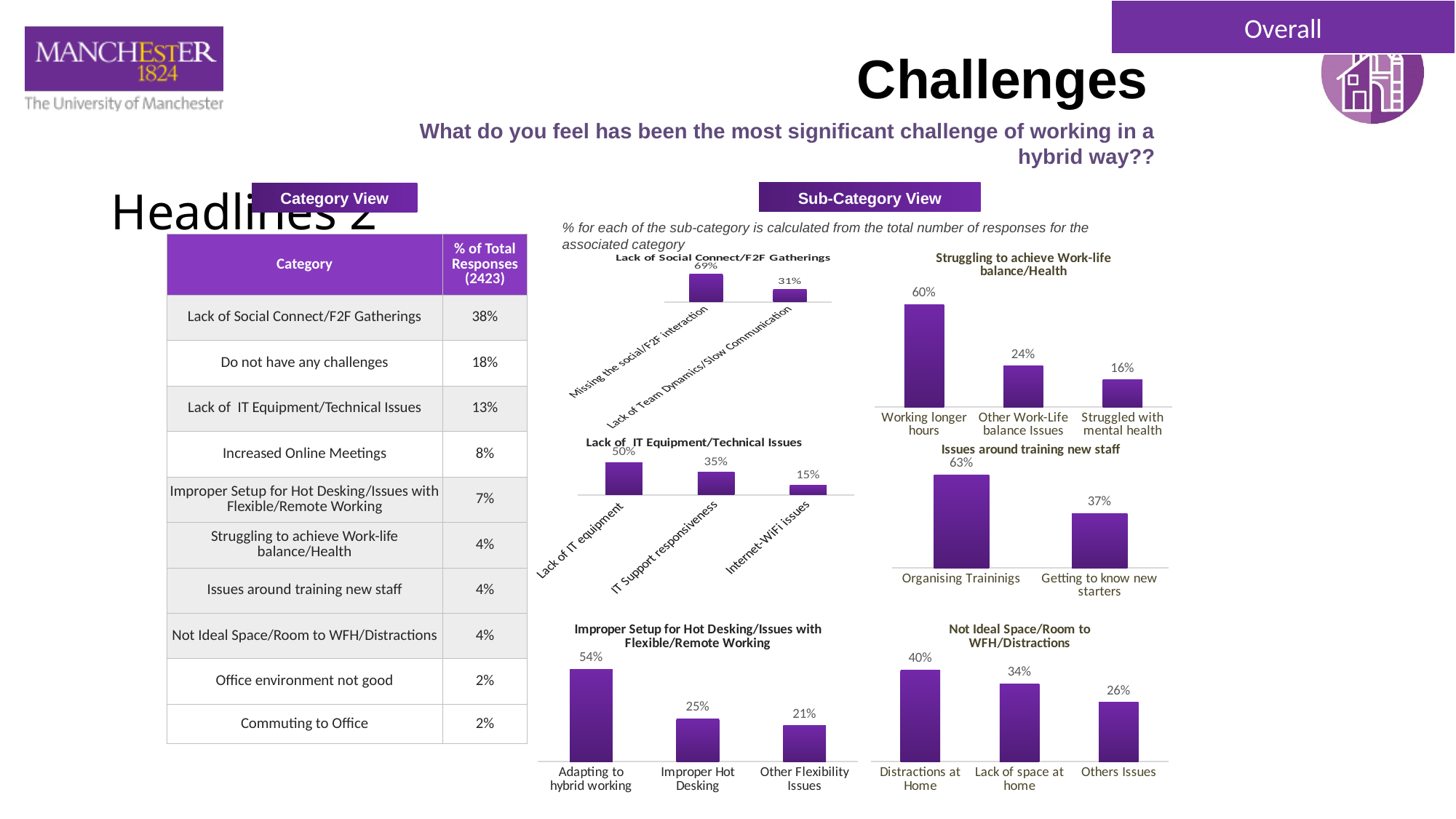
In the 'Issues around training new staff' chart, how many categories are plotted? 2 In the 'Improper Setup for Hot Desking/Issues with Flexible/Remote Working' chart, which is larger: 'Improper Hot Desking' or 'Other Flexibility Issues'? Improper Hot Desking In the 'Issues around training new staff' chart, what is the value for 'Getting to know new starters'? 37% What type of chart is the 'Struggling to achieve Work-life balance/Health' chart? bar chart In the 'Improper Setup for Hot Desking/Issues with Flexible/Remote Working' chart, what is the value for 'Adapting to hybrid working'? 54% In the 'Lack of Social Connect/F2F Gatherings' chart, what is the value for 'Missing the social/F2F interaction'? 69% In the 'Lack of IT Equipment/Technical Issues' chart, which category has the lowest value? Internet-WiFi issues In the 'Lack of IT Equipment/Technical Issues' chart, what is the difference between 'Lack of IT equipment' and 'IT Support responsiveness'? 15% In the 'Struggling to achieve Work-life balance/Health' chart, which category has the highest value? Working longer hours In the 'Not Ideal Space/Room to WFH/Distractions' chart, what is the difference between 'Distractions at Home' and 'Others Issues'? 14% In the 'Struggling to achieve Work-life balance/Health' chart, what is the value for 'Struggled with mental health'? 16% In the 'Not Ideal Space/Room to WFH/Distractions' chart, do the values rise or fall from left to right? fall